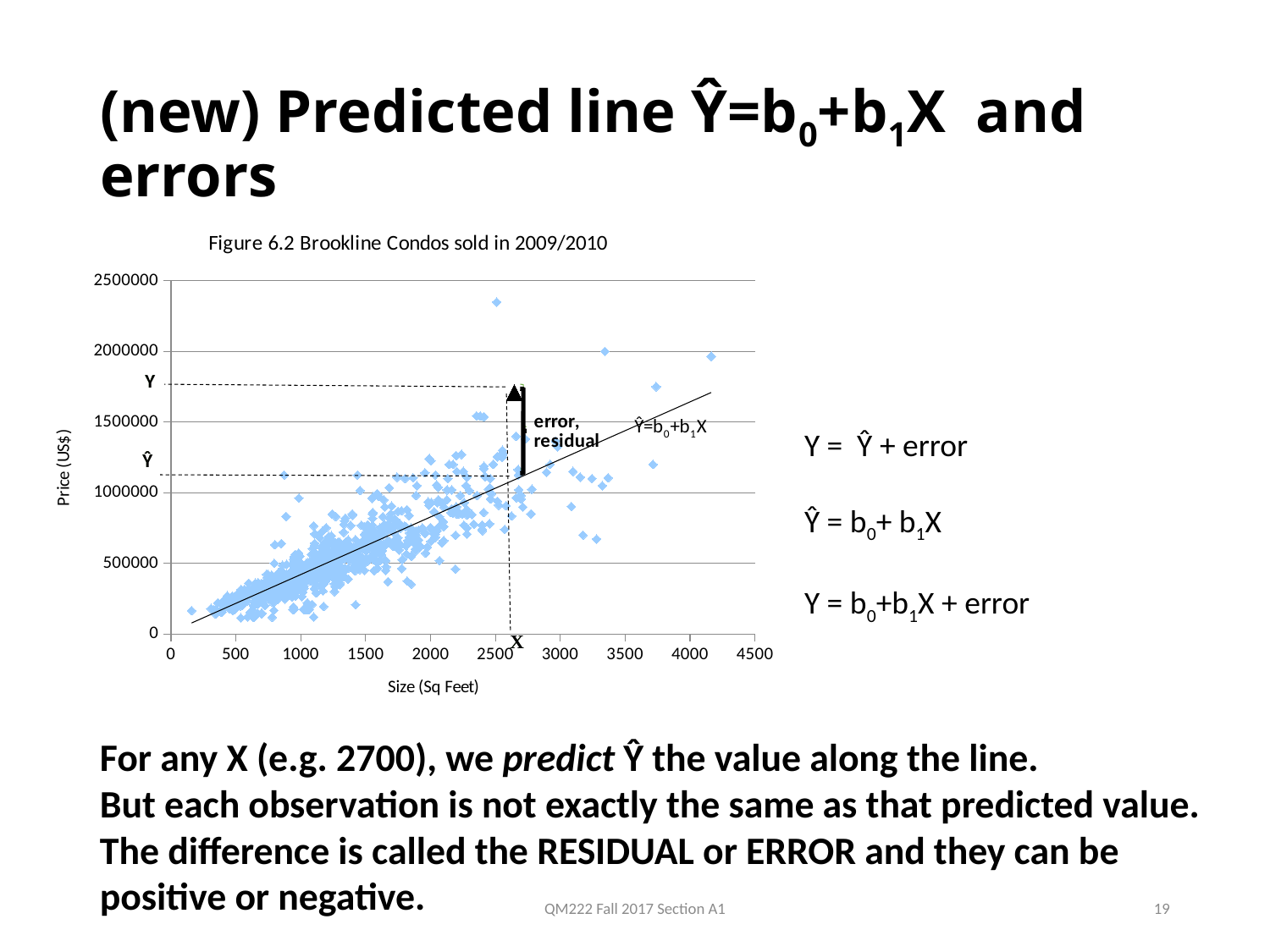
Is the predicted value Ŷ marked on the chart greater or less than the observed value Y marked on the chart? less Is the observed value Y marked on the chart greater or less than 1500000? greater Is the size of the highest-priced point in the scatter plot greater or less than 3000 square feet? less As size increases along the x axis, do the prices in the scatter plot generally rise or fall? rise What is the largest value shown on the vertical axis of the chart? 2500000 Is the X value marked on the chart greater or less than 2500? greater What kind of chart is shown on the slide? scatter plot What is the title of the chart? Figure 6.2 Brookline Condos sold in 2009/2010 What is the label of the horizontal axis of the chart? Size (Sq Feet)